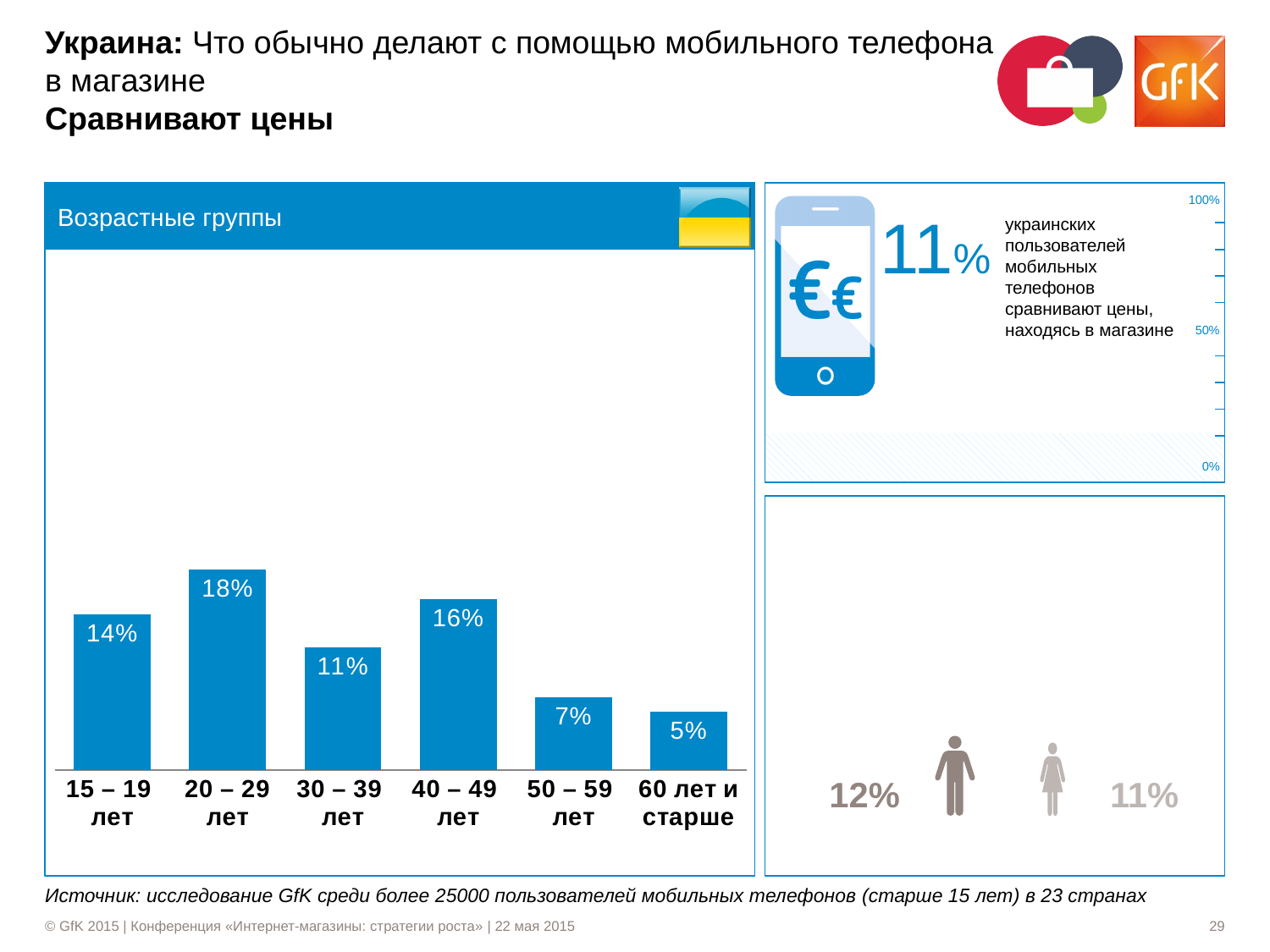
In the "Возрастные группы" bar chart, what is the difference between the values for 20 – 29 лет and 50 – 59 лет? 11% According to the panel on the right, what share of Ukrainian mobile phone users compare prices while in a store? 11% How many age groups are shown in the "Возрастные группы" bar chart? 6 What kind of chart is the "Возрастные группы" chart? bar chart In the gender panel on the right of the slide, what is the value shown for men? 12% In the "Возрастные группы" bar chart, do the values rise or fall from 40 – 49 лет to 60 лет и старше? fall In the "Возрастные группы" bar chart, what is the value for the 40 – 49 лет age group? 16% In the "Возрастные группы" bar chart, what is the value for the 60 лет и старше age group? 5% In the "Возрастные группы" bar chart, which is larger: the value for 15 – 19 лет or the value for 30 – 39 лет? 15 – 19 лет In the "Возрастные группы" bar chart, which age group has the lowest value? 60 лет и старше In the "Возрастные группы" bar chart, which age group has the highest value? 20 – 29 лет In the "Возрастные группы" bar chart, what is the value for the 20 – 29 лет age group? 18%